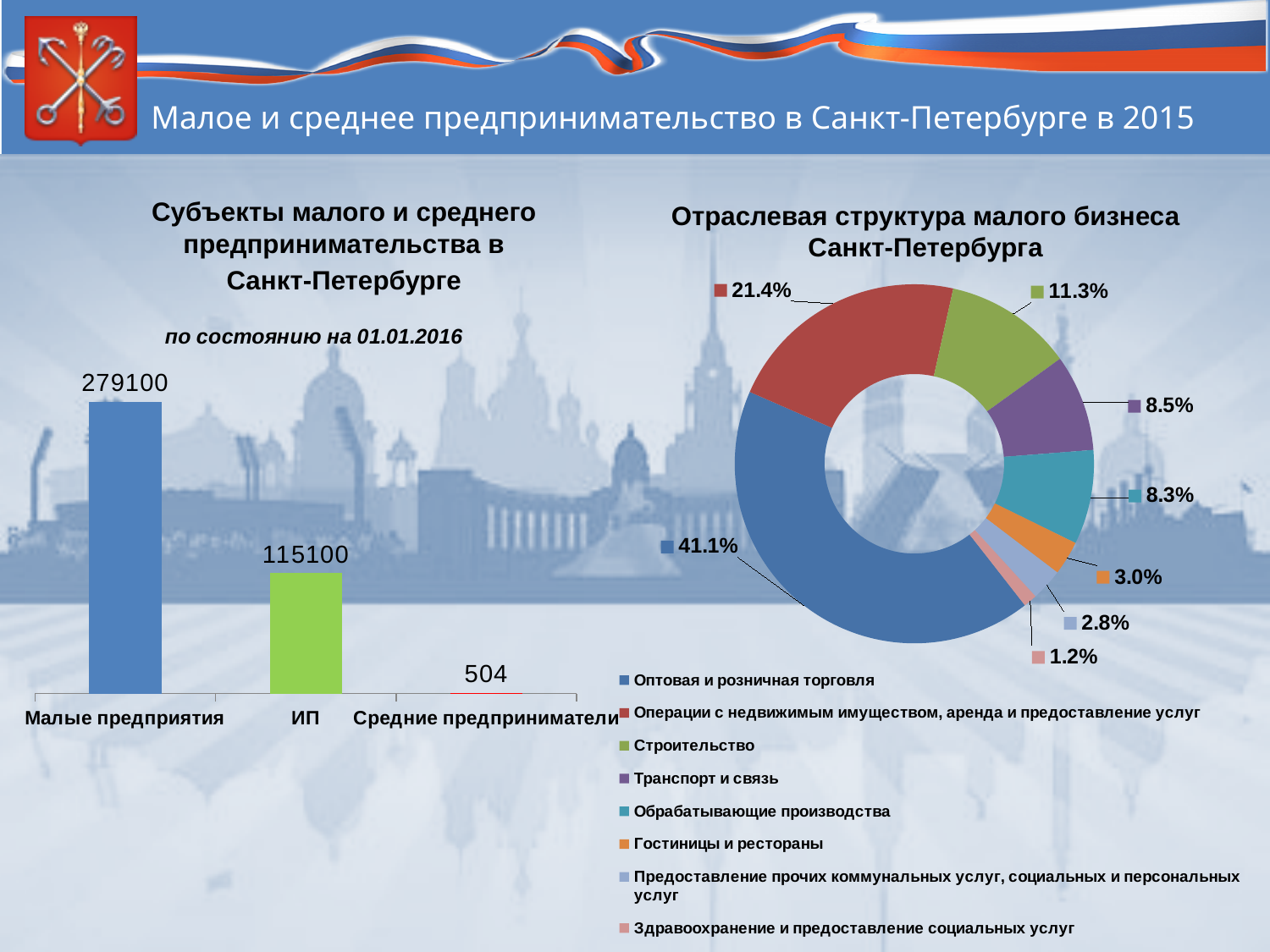
In the bar chart on the left, what is the difference between the values for Малые предприятия and ИП? 164000 In the doughnut chart on the right, what is the value for Строительство? 11.3% In the bar chart on the left, what is the value for ИП? 115100 In the doughnut chart on the right, which sector has the smallest share? Здравоохранение и предоставление социальных услуг In the bar chart on the left, what is the value for Средние предприниматели? 504 In the bar chart on the left, how many categories are shown? 3 In the doughnut chart on the right, what share does Оптовая и розничная торговля have? 41.1% In the doughnut chart on the right, which is larger: Транспорт и связь or Гостиницы и рестораны? Транспорт и связь In the bar chart on the left, what is the value for Малые предприятия? 279100 In the bar chart on the left, which category has the lowest value? Средние предприниматели How many entries does the legend of the doughnut chart on the right list? 8 What kind of chart is the chart titled 'Отраслевая структура малого бизнеса Санкт-Петербурга'? Doughnut chart